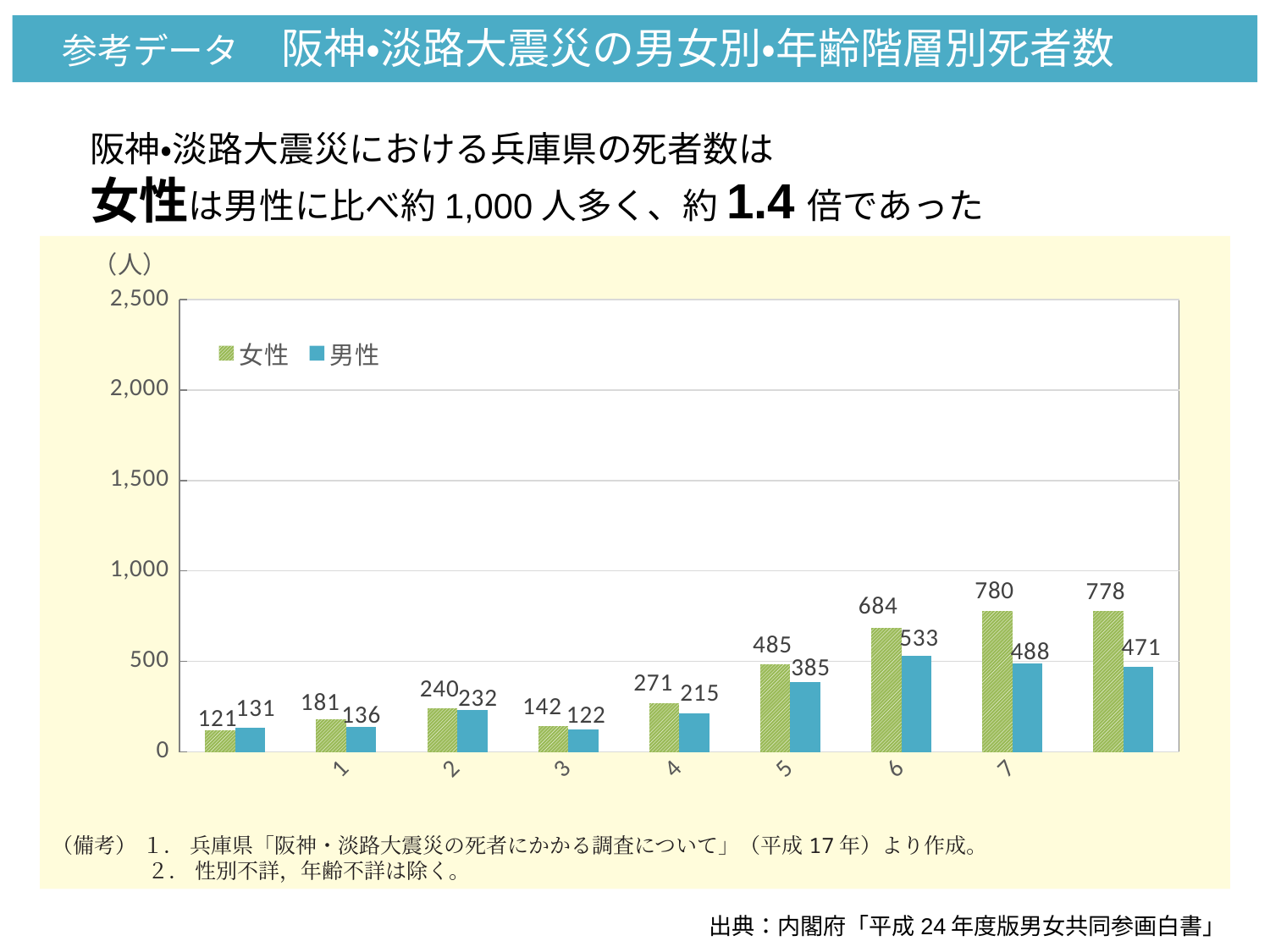
What unit is shown at the top of the vertical axis? （人） What is the value for 女性 at category 4? 271 What is the value for 女性 at category 7? 780 What is the difference between 女性 and 男性 at category 6? 151 What is the value for 男性 at category 5? 385 Among the labeled categories 1 to 7, which has the lowest value for 男性? 3 Do the values for 女性 rise or fall from category 3 to category 7? rise What is the difference between 女性 and 男性 at category 7? 292 What kind of chart is shown on the slide? bar chart How many series does the legend list? 2 Which category has the highest value for 男性? 6 At category 3, which series has the larger value, 女性 or 男性? 女性